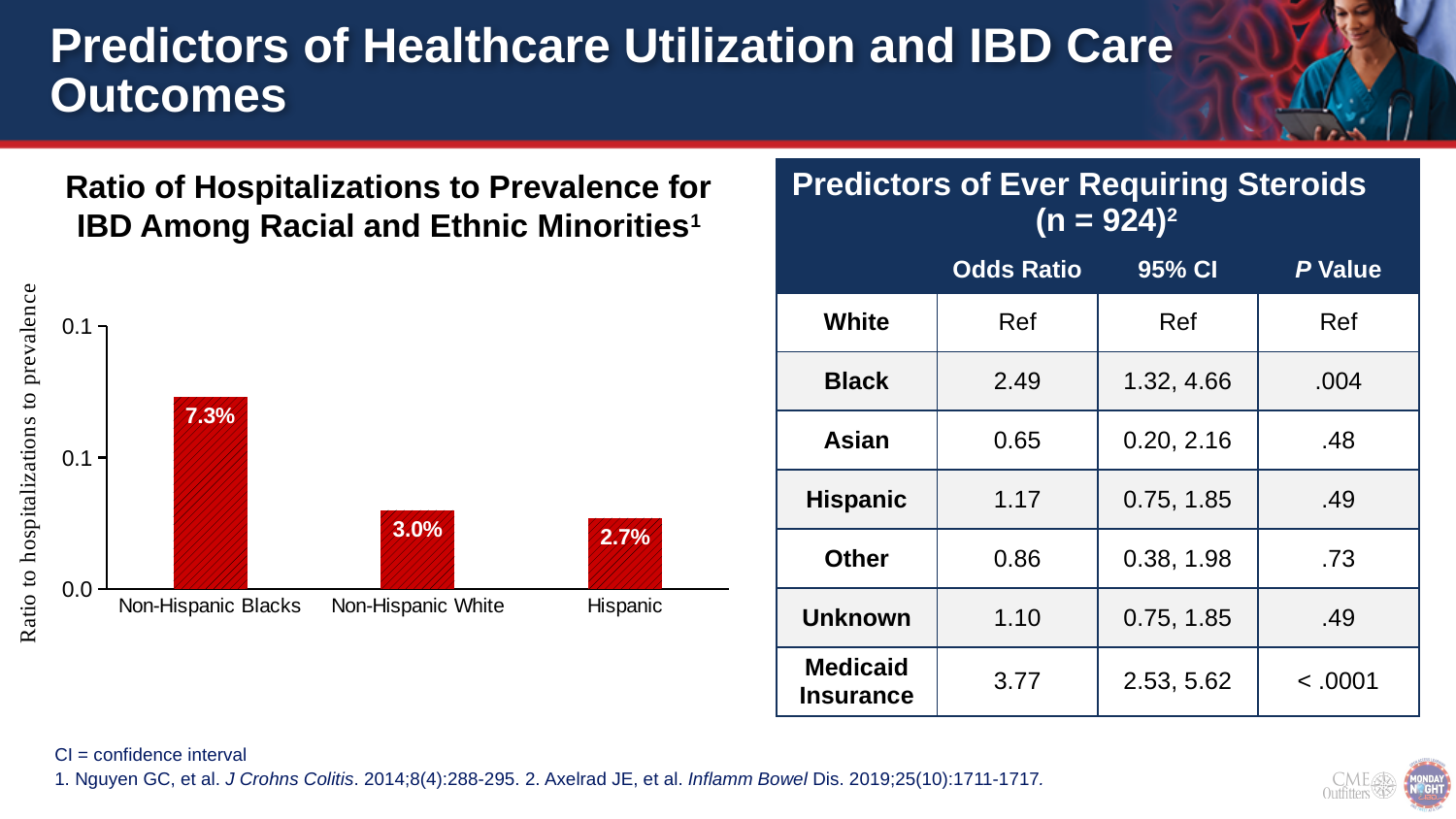
What is the difference between the values for Non-Hispanic Blacks and Non-Hispanic White in the chart? 4.3% Which category has the lowest ratio of hospitalizations to prevalence in the chart? Hispanic What is the difference between the values for Non-Hispanic White and Hispanic in the chart? 0.3% How many categories are shown in the chart? 3 What is the value for Non-Hispanic White in the chart? 3.0% Which is larger in the chart, the value for Non-Hispanic White or the value for Hispanic? Non-Hispanic White What is the value for Non-Hispanic Blacks in the chart? 7.3% What is the difference between the values for Non-Hispanic Blacks and Hispanic in the chart? 4.6% Which category has the highest ratio of hospitalizations to prevalence in the chart? Non-Hispanic Blacks What kind of chart is shown on the slide? Bar chart What is the title of the chart on the slide? Ratio of Hospitalizations to Prevalence for IBD Among Racial and Ethnic Minorities What is the value for Hispanic in the chart? 2.7%